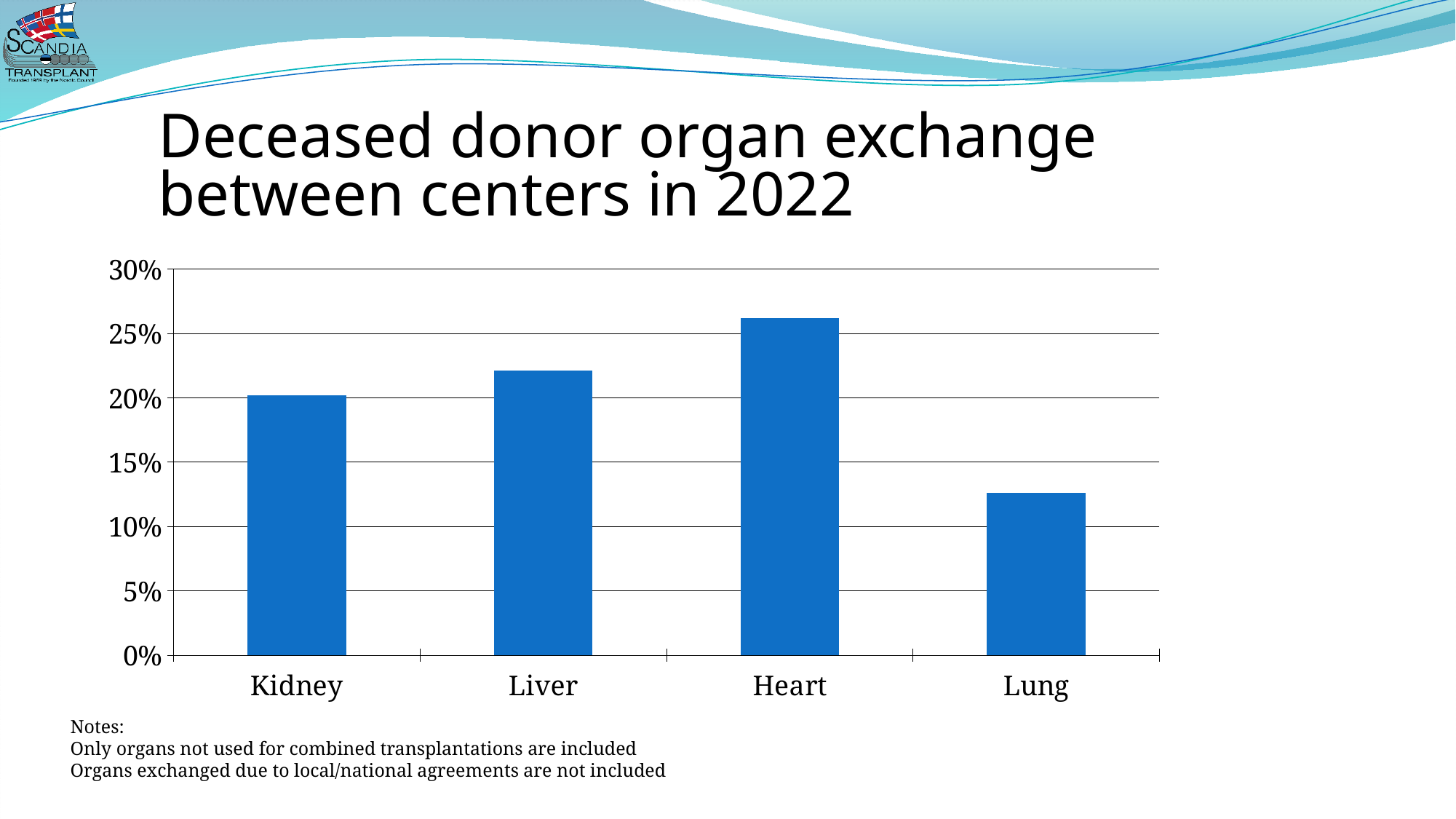
Which organ has the lowest share of deceased donor organ exchange between centers? Lung Is the value for Heart greater or less than 25%? greater What is the highest value shown on the vertical axis? 30% Which is larger, the value for Lung or the value for Heart? Heart Which is larger, the value for Liver or the value for Kidney? Liver Is the value for Liver greater or less than 20%? greater Is the value for Lung greater or less than 15%? less Which organ has the highest share of deceased donor organ exchange between centers? Heart How many organ categories are shown on the chart? 4 What is the title of the slide containing the chart? Deceased donor organ exchange between centers in 2022 What kind of chart is shown on the slide? bar chart